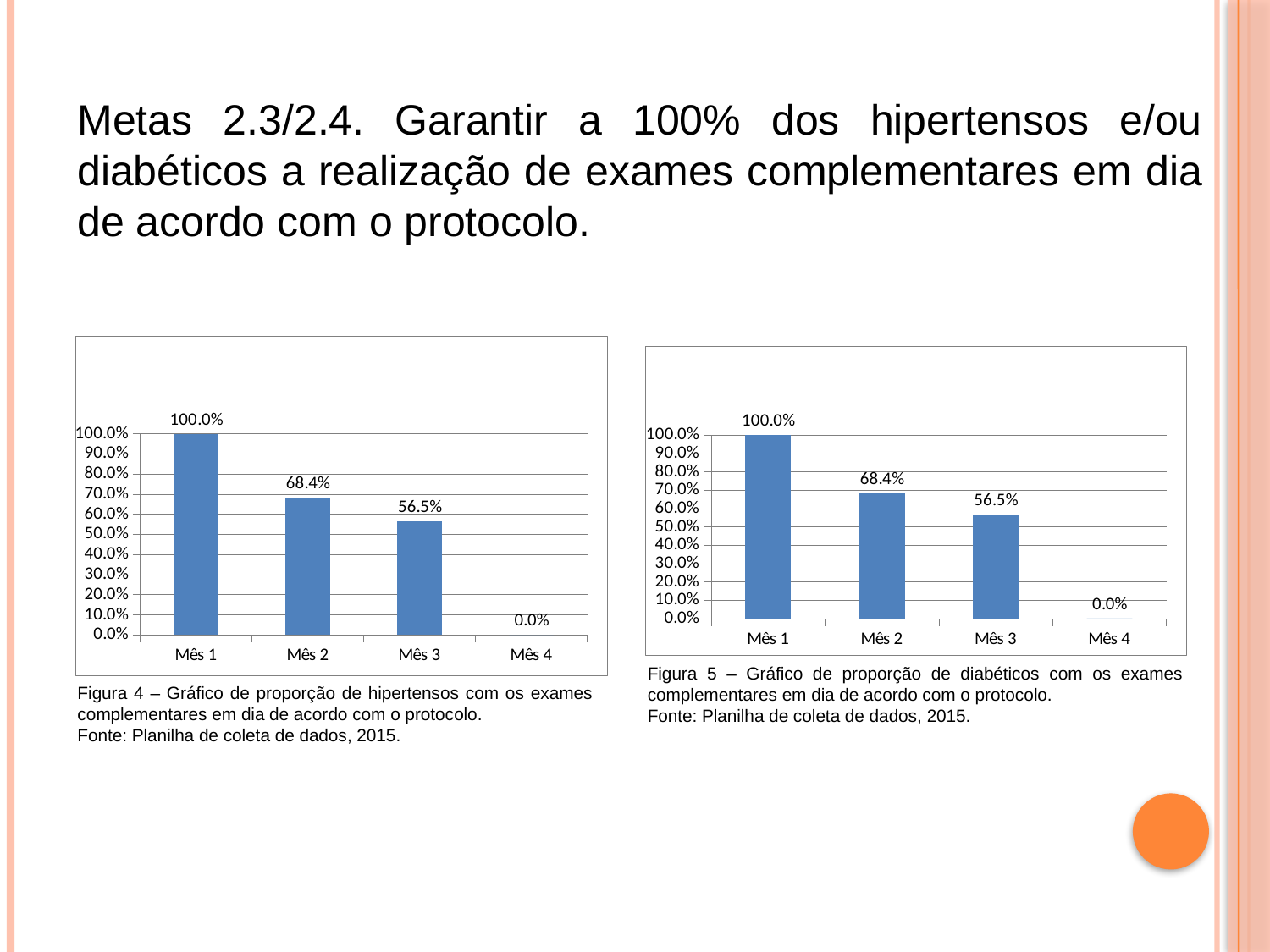
In the left chart (Figura 4, hipertensos), what is the value for Mês 2? 68.4% In the right chart (Figura 5, diabéticos), is the value for Mês 3 greater or less than 50.0%? greater What kind of chart is the right chart (Figura 5, diabéticos)? Bar chart In the right chart (Figura 5, diabéticos), what is the value for Mês 3? 56.5% In the right chart (Figura 5, diabéticos), what is the difference between the values for Mês 2 and Mês 3? 11.9% In the right chart (Figura 5, diabéticos), what is the value for Mês 4? 0.0% In the left chart (Figura 4, hipertensos), which month has the highest value? Mês 1 How many months (categories) are shown in the left chart (Figura 4, hipertensos)? 4 In the right chart (Figura 5, diabéticos), which month has the lowest value? Mês 4 In the left chart (Figura 4, hipertensos), what is the difference between the values for Mês 1 and Mês 2? 31.6% In the left chart (Figura 4, hipertensos), which is larger, the value for Mês 2 or Mês 3? Mês 2 In the left chart (Figura 4, hipertensos), do the values rise or fall from Mês 1 to Mês 4? Fall